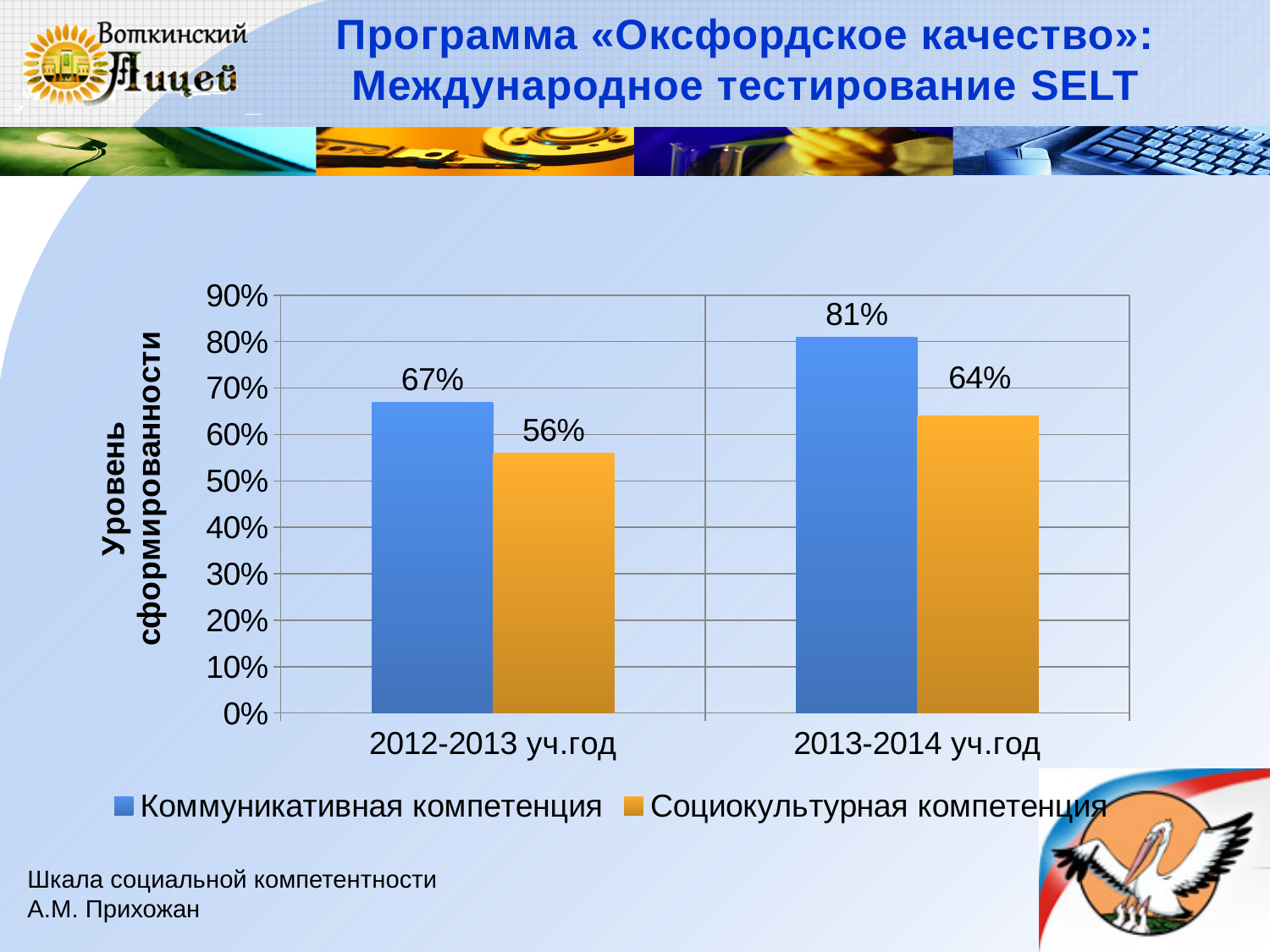
What is the value for Коммуникативная компетенция in 2013-2014 уч.год? 81% How many categories are shown on the x axis? 2 Which is larger in 2012-2013 уч.год: Коммуникативная компетенция or Социокультурная компетенция? Коммуникативная компетенция What kind of chart is shown on the slide? Bar chart What is the value for Социокультурная компетенция in 2012-2013 уч.год? 56% What is the difference between Коммуникативная компетенция in 2013-2014 уч.год and in 2012-2013 уч.год? 14% What is the value for Коммуникативная компетенция in 2012-2013 уч.год? 67% How many series does the legend list? 2 Which bar has the highest value on the chart? Коммуникативная компетенция, 2013-2014 уч.год Do the values for Социокультурная компетенция rise or fall from 2012-2013 уч.год to 2013-2014 уч.год? Rise Which bar has the lowest value on the chart? Социокультурная компетенция, 2012-2013 уч.год What is the value for Социокультурная компетенция in 2013-2014 уч.год? 64%